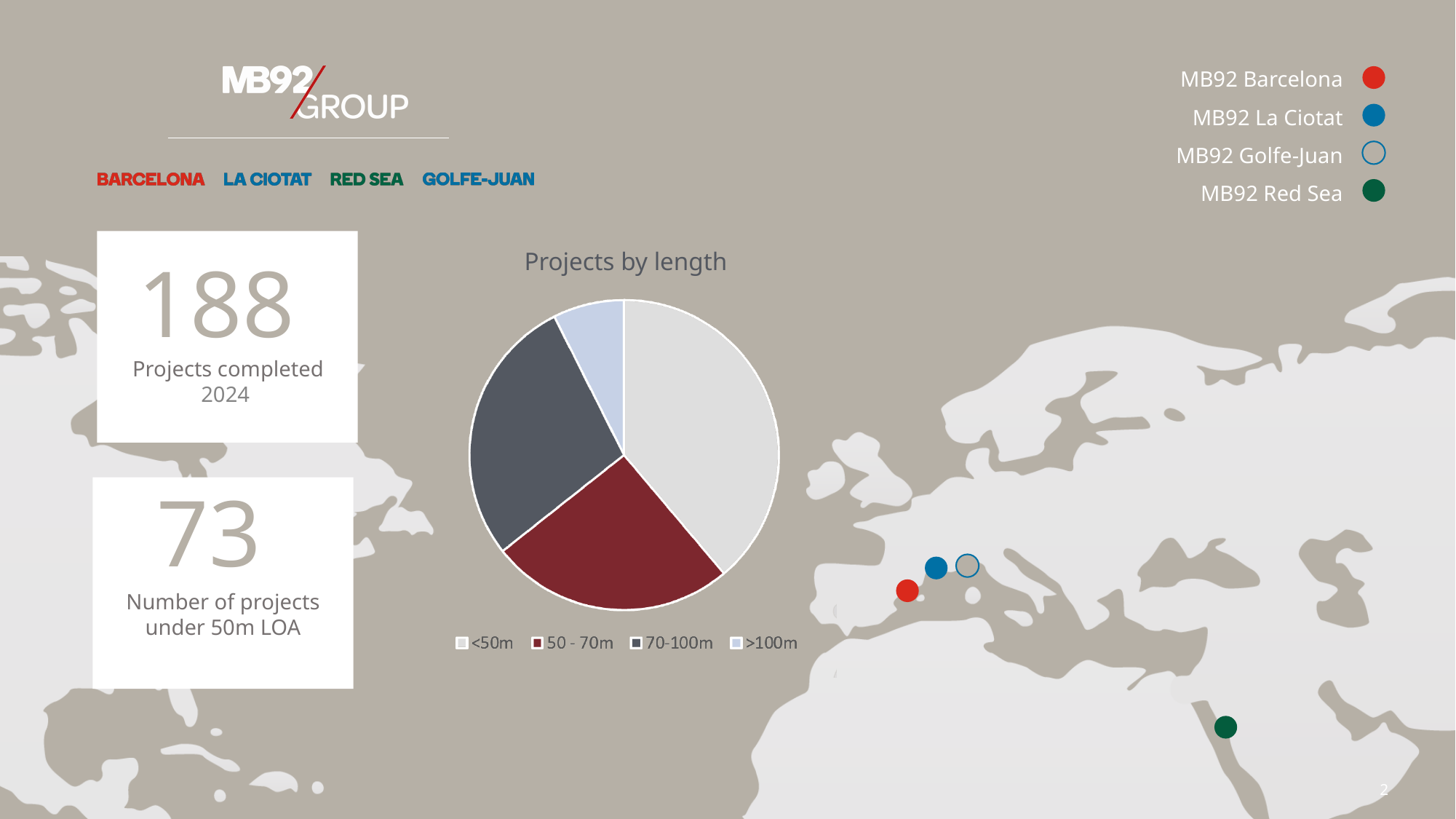
How many length categories does the "Projects by length" pie chart show? 4 Which length category has the smallest slice in the "Projects by length" pie chart? >100m In the "Projects by length" pie chart, which slice is larger: <50m or >100m? <50m What is the title of the pie chart on the slide? Projects by length In the "Projects by length" pie chart, which slice is larger: <50m or 70-100m? <50m Which length category has the largest slice in the "Projects by length" pie chart? <50m In the "Projects by length" pie chart, which slice is larger: 70-100m or >100m? 70-100m What colour is the 50 - 70m slice in the "Projects by length" pie chart? dark red What kind of chart is shown under the title "Projects by length"? pie chart